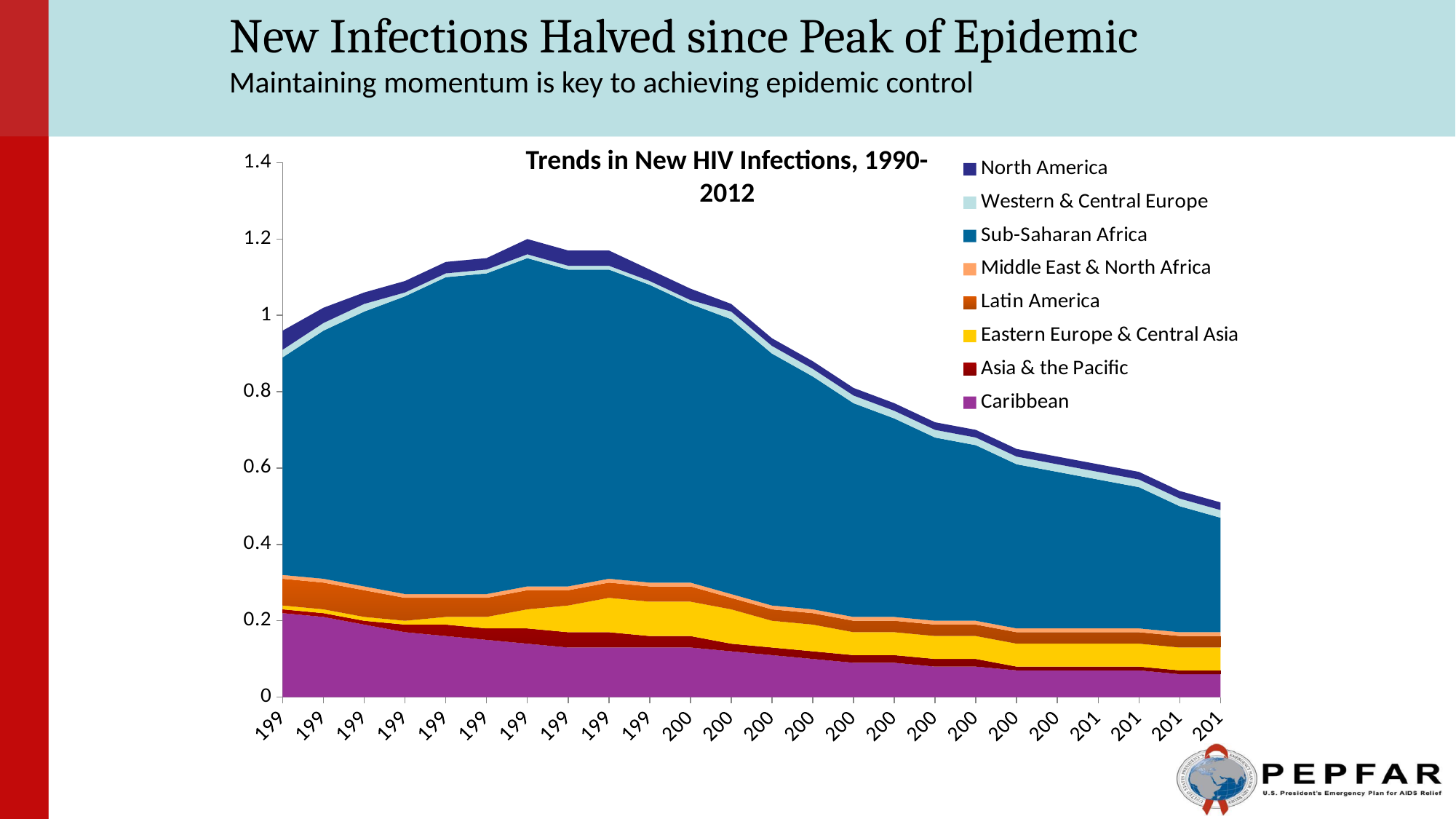
Is the total of the stacked areas at the last year shown greater or less than 0.6? less How many series does the legend of the 'Trends in New HIV Infections' chart list? 8 Does the Eastern Europe & Central Asia area grow or shrink between the early 1990s and the late 1990s? Grow Which is larger in the chart, the Sub-Saharan Africa area or the Caribbean area? Sub-Saharan Africa Is the total of the stacked areas at the peak of the epidemic greater or less than 1? greater What is the title of the chart? Trends in New HIV Infections, 1990-2012 Is the total of the stacked areas at the first year shown greater or less than 0.8? greater What kind of chart is shown on the slide? Stacked area chart Which region accounts for the largest share of new HIV infections in the chart? Sub-Saharan Africa Is the total of the stacked areas larger at the start of the period or at the end of the period? At the start Does the total number of new HIV infections rise or fall from its peak to the end of the period shown? Fall Which series is listed last in the chart's legend? Caribbean